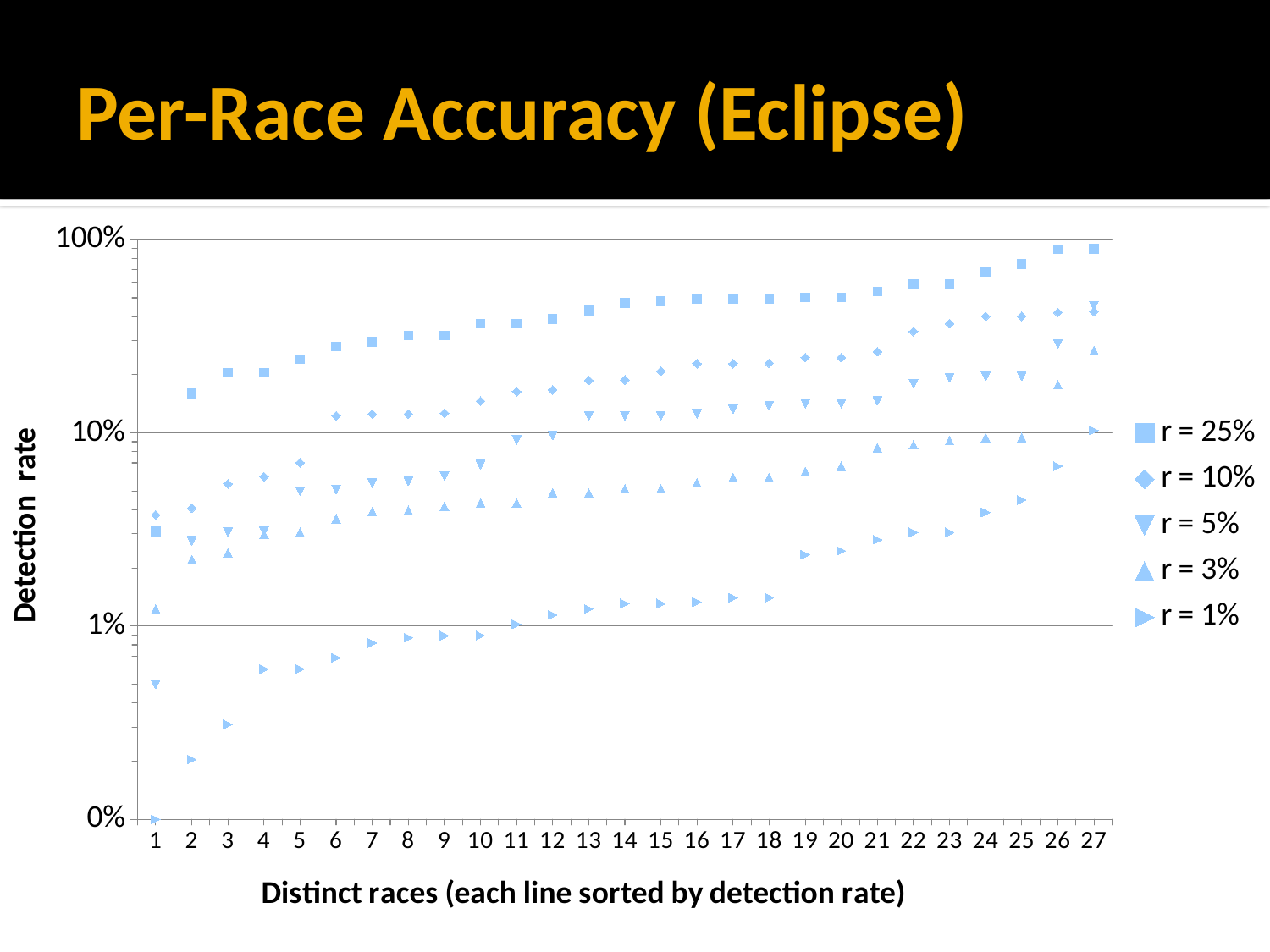
Is the detection rate for the r = 25% series at race 1 greater or less than 10%? less What kind of chart is shown on the slide? scatter chart Is the detection rate for the r = 1% series at race 2 greater or less than 1%? less What is the label of the y axis? Detection rate Which series has the highest detection rate at race 27? r = 25% Is the detection rate for the r = 25% series at race 27 greater or less than 10%? greater How many distinct races are plotted along the x axis? 27 At race 27, which series has the higher detection rate, r = 25% or r = 1%? r = 25% Do the detection rates for the r = 25% series rise or fall as the race number increases? rise How many series does the legend list? 5